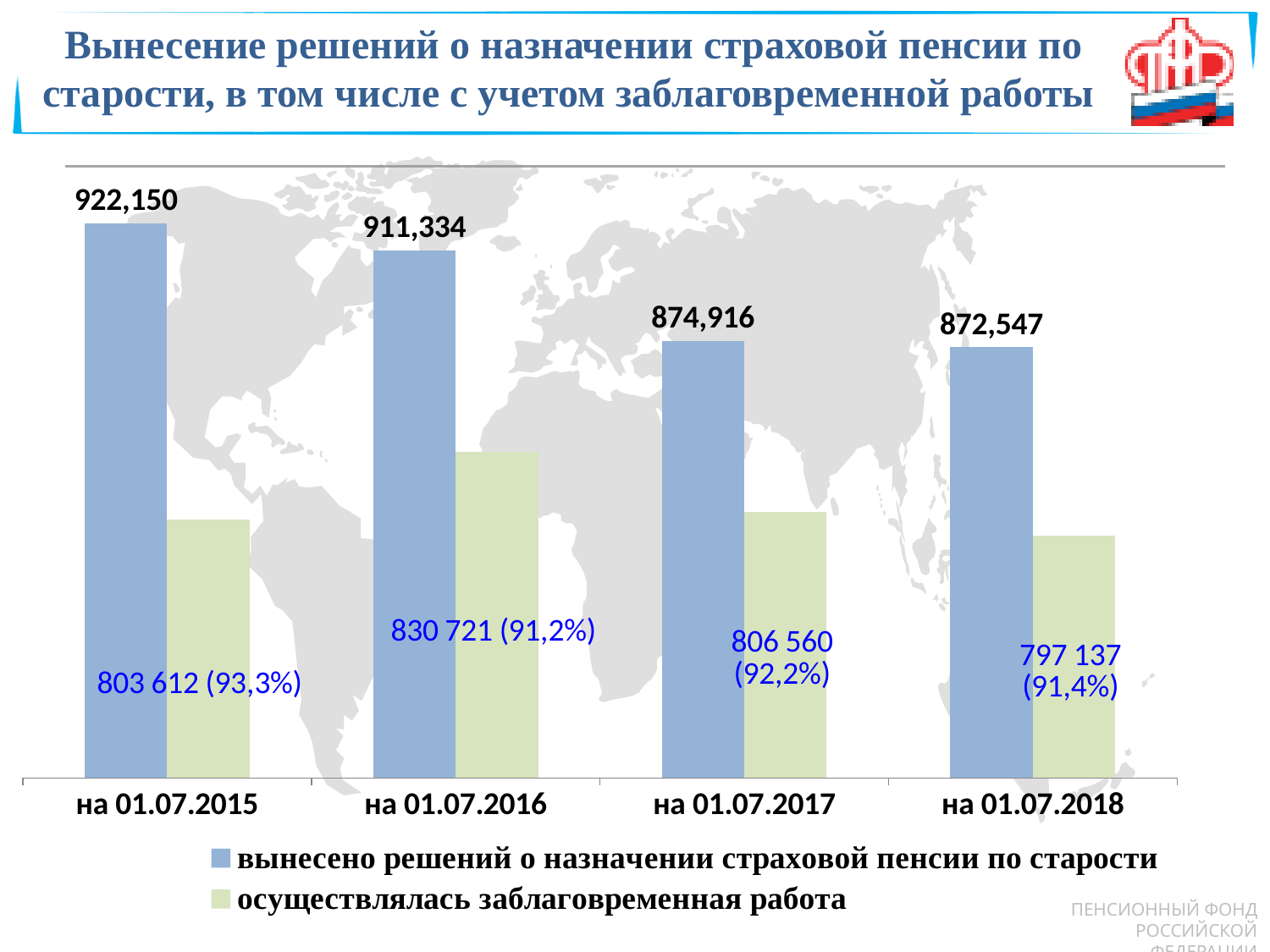
How many decisions on assigning an old-age insurance pension were made as of 01.07.2015? 922,150 Which is larger: the advance-work value as of 01.07.2016 or as of 01.07.2017? на 01.07.2016 How many dates (categories) are shown on the x axis? 4 What is the difference between the number of decisions as of 01.07.2015 and as of 01.07.2016? 10,816 On which date is the value of the 'осуществлялась заблаговременная работа' series the lowest? на 01.07.2018 What type of chart is shown on the slide? bar chart On which date is the number of decisions on assigning an old-age insurance pension the highest? на 01.07.2015 What is the value of the 'осуществлялась заблаговременная работа' series as of 01.07.2016? 830 721 (91,2%) Do the values of the 'вынесено решений о назначении страховой пенсии по старости' series rise or fall from 01.07.2015 to 01.07.2018? fall What is the value of the 'вынесено решений о назначении страховой пенсии по старости' series as of 01.07.2018? 872,547 What percentage is shown next to the advance-work value as of 01.07.2017? 92,2% How many series does the legend list? 2